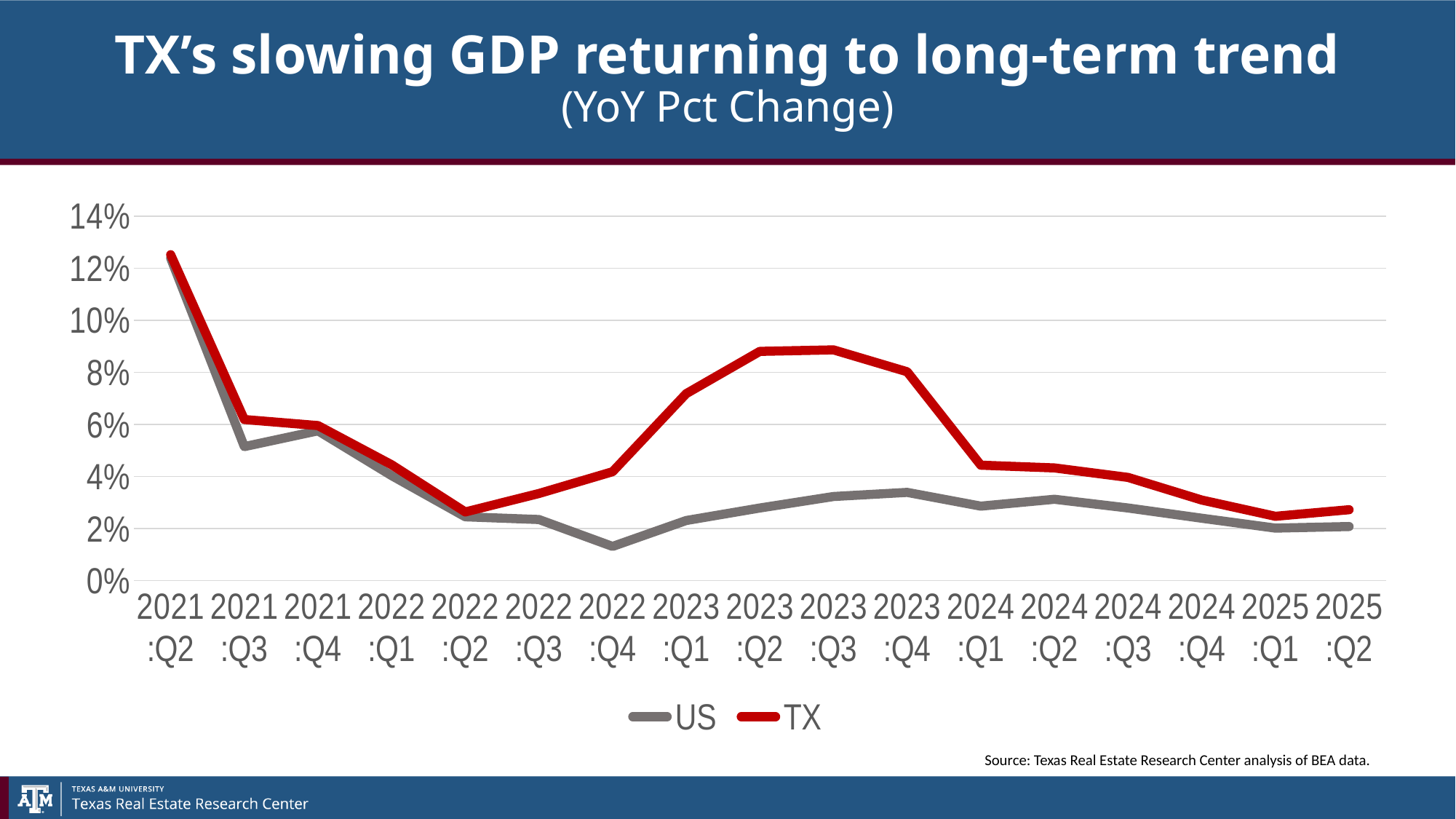
Is the TX value for 2021:Q2 greater or less than 12%? greater In which quarter does the TX series reach its highest value? 2021:Q2 Does the TX series rise or fall from 2023:Q4 to 2025:Q1? fall What is the subtitle shown under the chart title? (YoY Pct Change) In which quarter does the US series reach its lowest value? 2022:Q4 What colour is the line for the TX series? red Is the US value for 2022:Q4 greater or less than 2%? less Is the TX value for 2023:Q3 greater or less than 8%? greater What kind of chart is shown on the slide? line chart How many series does the legend list? 2 How many quarters are plotted along the x axis? 17 Which series has the higher value in 2023:Q2, US or TX? TX